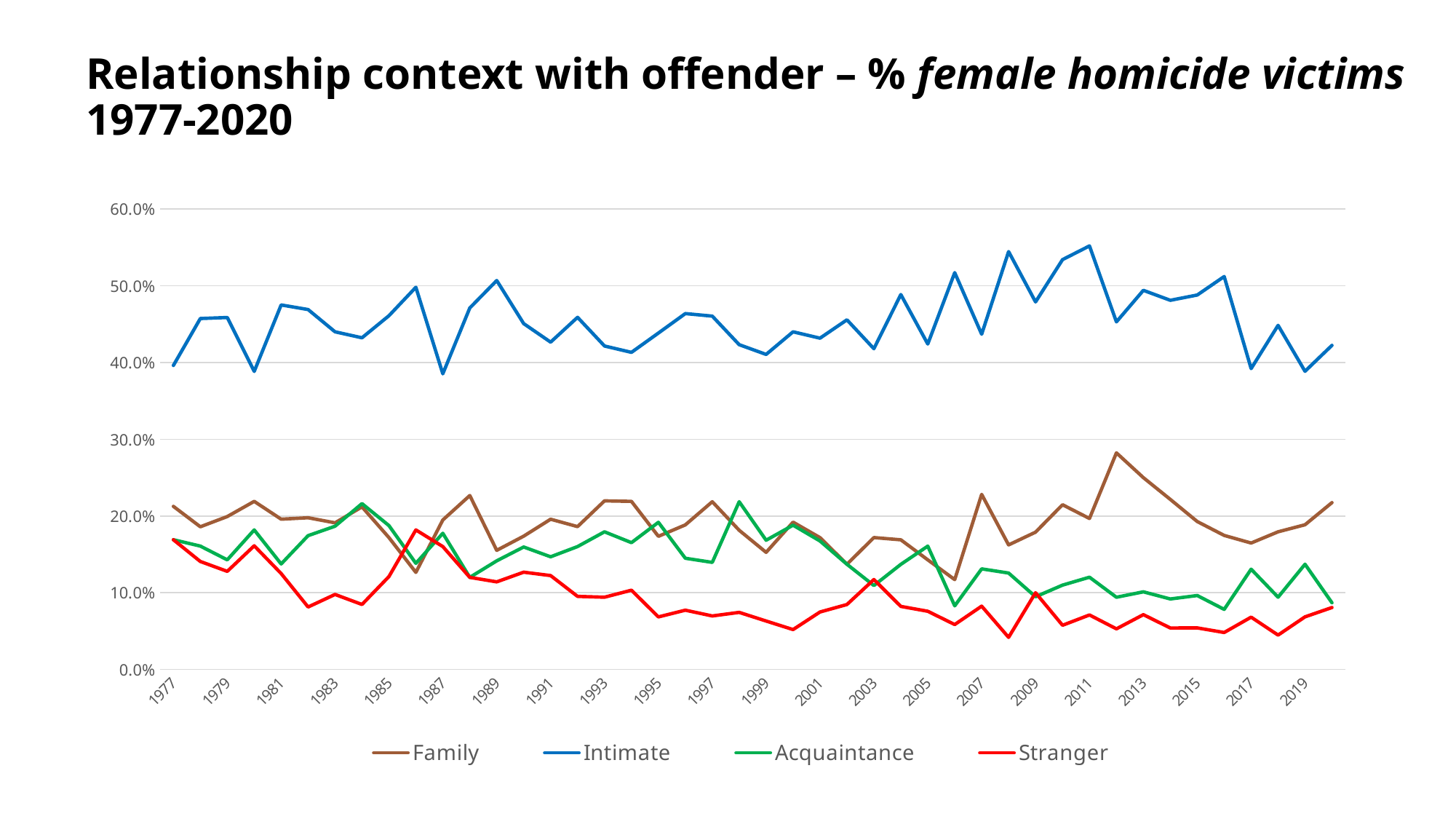
What colour is the line for the Intimate series? Blue Which series has the highest values across the whole period 1977-2020? Intimate Is the value for Intimate in 2011 greater or less than 50.0%? greater Is the value for Acquaintance in 2019 greater or less than 10.0%? greater Which series has the lowest value in 2019? Stranger In 2008, which is larger: the value for Stranger or the value for Acquaintance? Acquaintance What kind of chart is shown on the slide? Line chart Is the value for Stranger in 2008 greater or less than 10.0%? less Does the Stranger series generally rise or fall from 1977 to 2020? Fall In 2012, which is larger: the value for Family or the value for Acquaintance? Family How many series does the legend list? 4